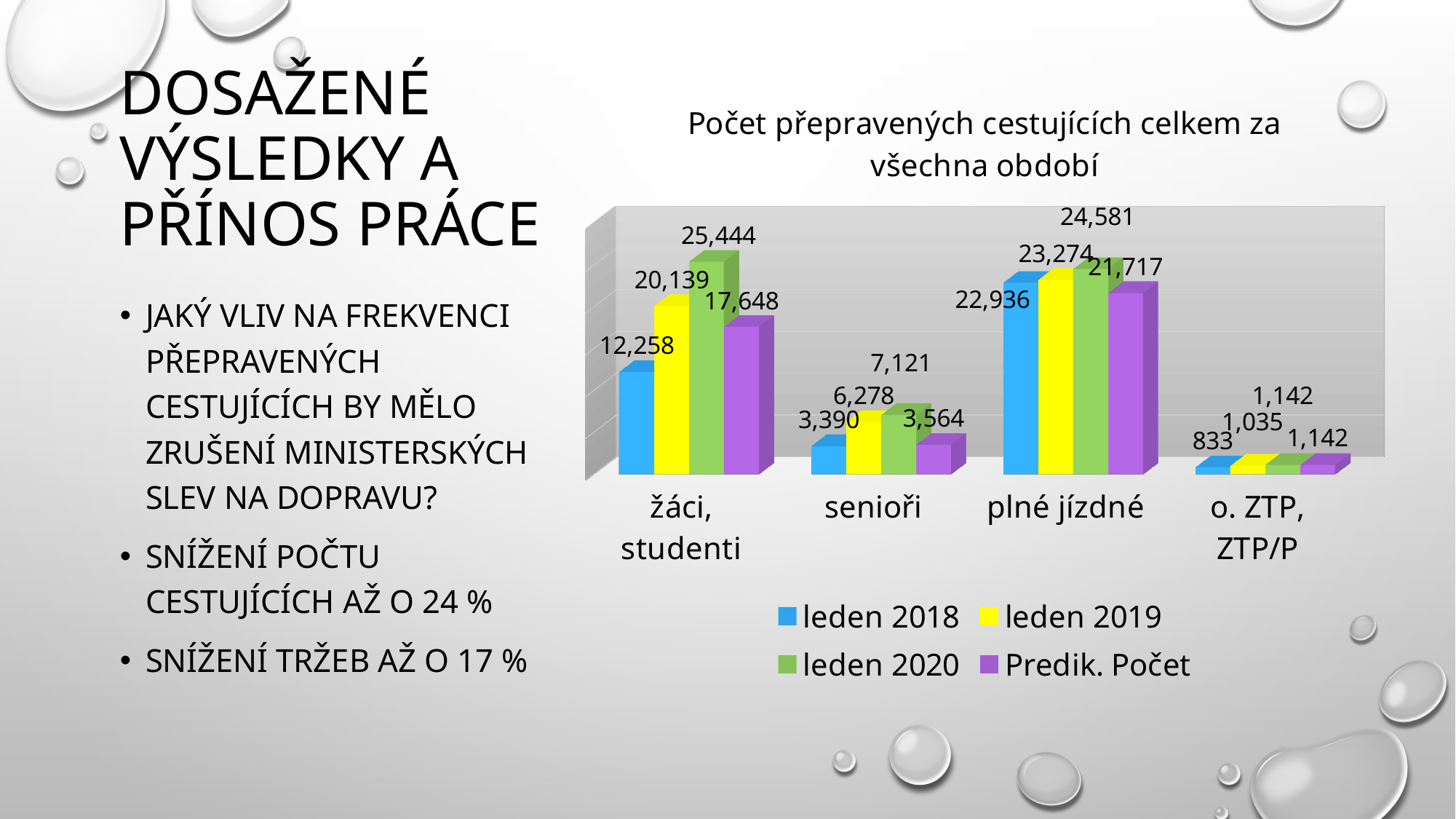
What is the Predik. Počet value for senioři? 3,564 What is the value for leden 2018 in the plné jízdné category? 22,936 What is the difference between the leden 2020 and leden 2018 values for žáci, studenti? 13,186 What is the title of the chart? Počet přepravených cestujících celkem za všechna období Which category has the highest leden 2020 value? žáci, studenti How many series does the legend list? 4 Which is larger for plné jízdné: the leden 2019 value or the Predik. Počet value? leden 2019 What kind of chart is shown on the slide? bar chart What is the value for leden 2019 in the o. ZTP, ZTP/P category? 1,035 How many categories are shown on the x axis? 4 Which category has the lowest leden 2018 value? o. ZTP, ZTP/P What is the value for leden 2020 in the žáci, studenti category? 25,444